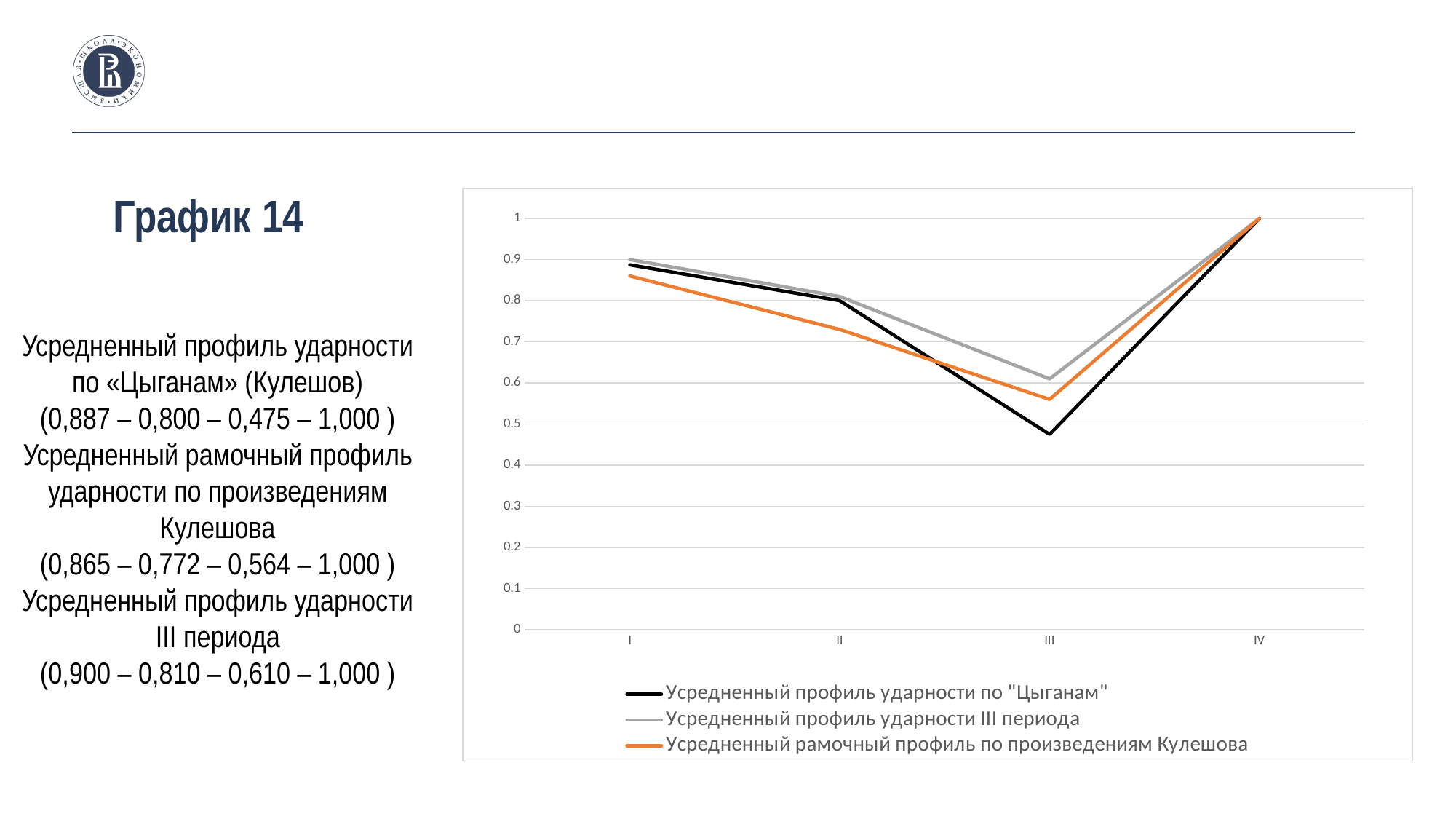
What is the difference at point III between "Усредненный профиль ударности III периода" and "Усредненный профиль ударности по "Цыганам""? 0,135 How many series does the legend list? 3 At point III, which series is higher: "Усредненный профиль ударности III периода" or "Усредненный профиль ударности по "Цыганам""? Усредненный профиль ударности III периода Is the value for "Усредненный профиль ударности по "Цыганам"" at point III greater or less than 0.5? less What kind of chart is shown on the slide? line chart Do the series rise or fall from point III to point IV? rise How many points are plotted along the x axis for each series? 4 At which point does "Усредненный профиль ударности по "Цыганам"" reach its lowest value? III What colour is the line for "Усредненный профиль ударности по "Цыганам""? black What is the value of "Усредненный профиль ударности III периода" at point I? 0,900 What is the value of "Усредненный профиль ударности по "Цыганам"" at point III? 0,475